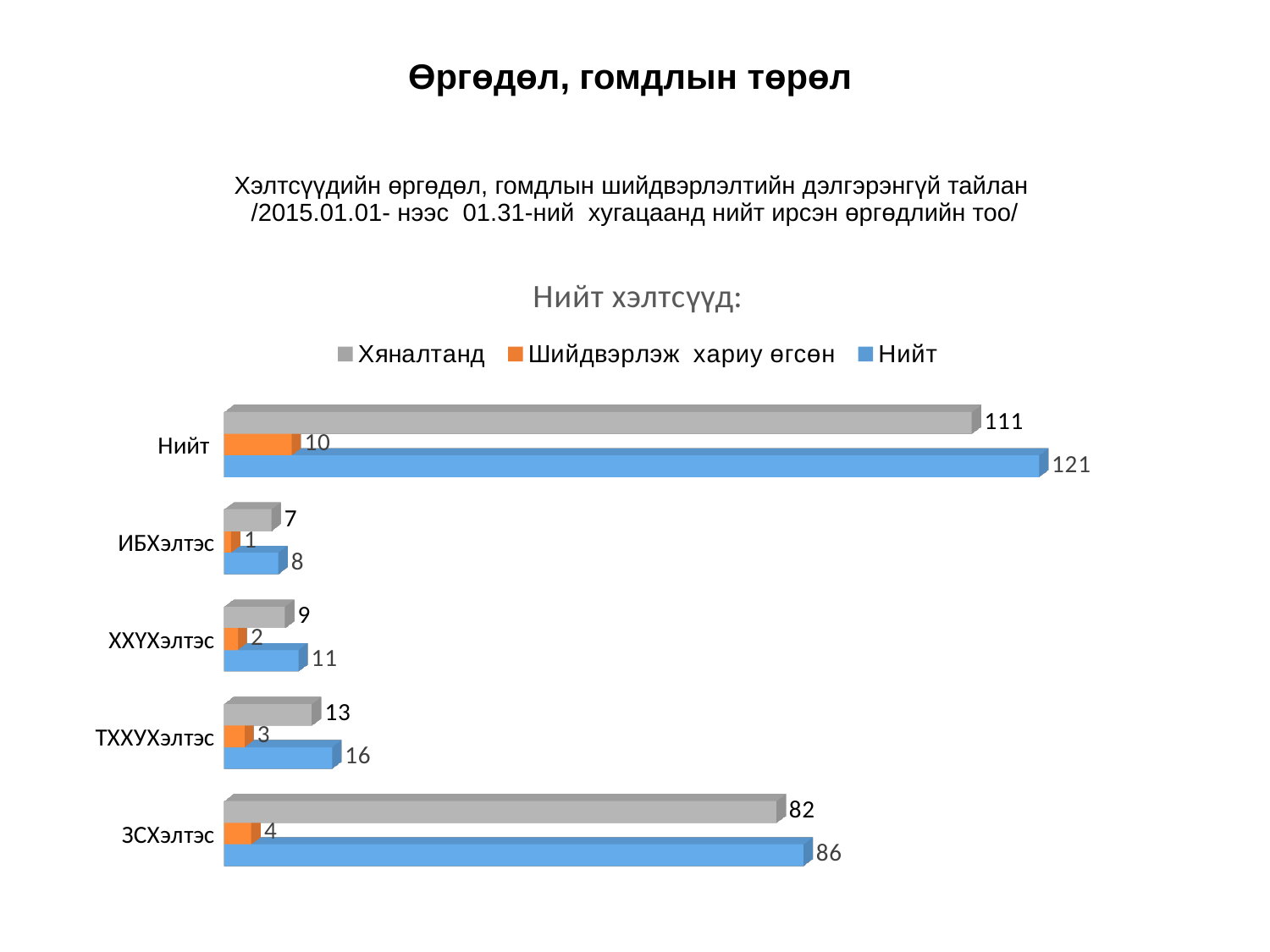
Which department category has the lowest value in the Нийт series? ИБХэлтэс What is the value of the Нийт series for the Нийт category? 121 Which is larger: the Шийдвэрлэж хариу өгсөн value for ЗСХэлтэс or for ТХХУХэлтэс? ЗСХэлтэс What is the difference between the Нийт values for ТХХУХэлтэс and ХХҮХэлтэс? 5 What is the value of the Хяналтанд series for ТХХУХэлтэс? 13 Excluding the Нийт category, which department has the highest value in the Хяналтанд series? ЗСХэлтэс How many categories are shown on the y axis of the chart? 5 How many series does the legend list? 3 What is the value of the Шийдвэрлэж хариу өгсөн series for ХХҮХэлтэс? 2 What is the difference between the Нийт and Хяналтанд values for ЗСХэлтэс? 4 What is the value of the Нийт series for ЗСХэлтэс? 86 What type of chart is shown on the slide? Bar chart